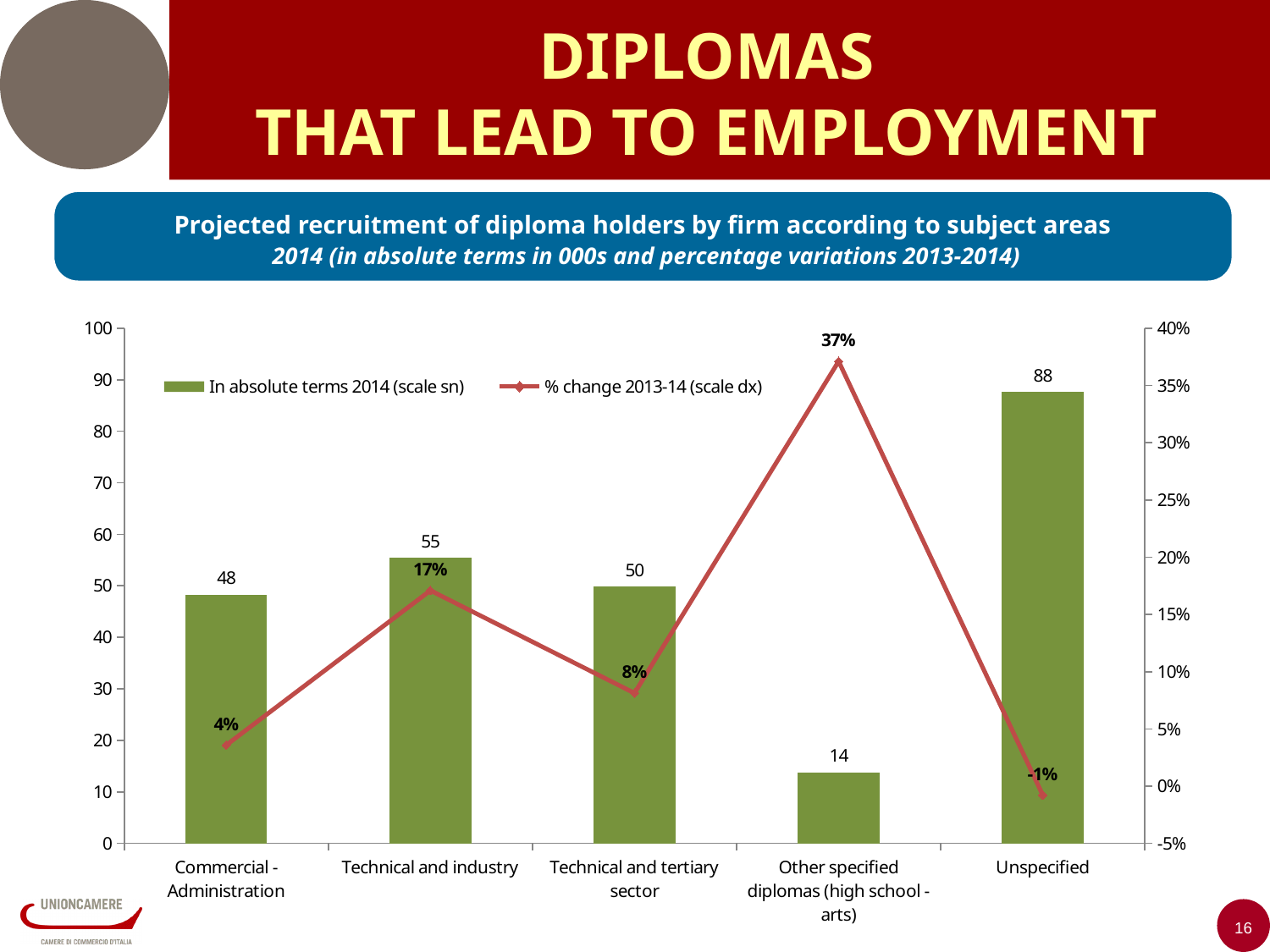
Which category has the lowest % change 2013-14? Unspecified What is the value in absolute terms 2014 for Technical and industry? 55 What is the total of the absolute terms 2014 values for Technical and industry and Technical and tertiary sector? 105 How many series does the legend list? 2 What is the % change 2013-14 for Commercial - Administration? 4% Which has a larger value in absolute terms 2014, Commercial - Administration or Technical and tertiary sector? Technical and tertiary sector How many categories are shown on the x axis? 5 What is the difference in absolute terms 2014 between Unspecified and Other specified diplomas (high school - arts)? 74 What is the % change 2013-14 for Other specified diplomas (high school - arts)? 37% What is the value in absolute terms 2014 for Unspecified? 88 Which category has the highest value in absolute terms 2014? Unspecified What kind of chart is used for the 'In absolute terms 2014 (scale sn)' series? Bar chart